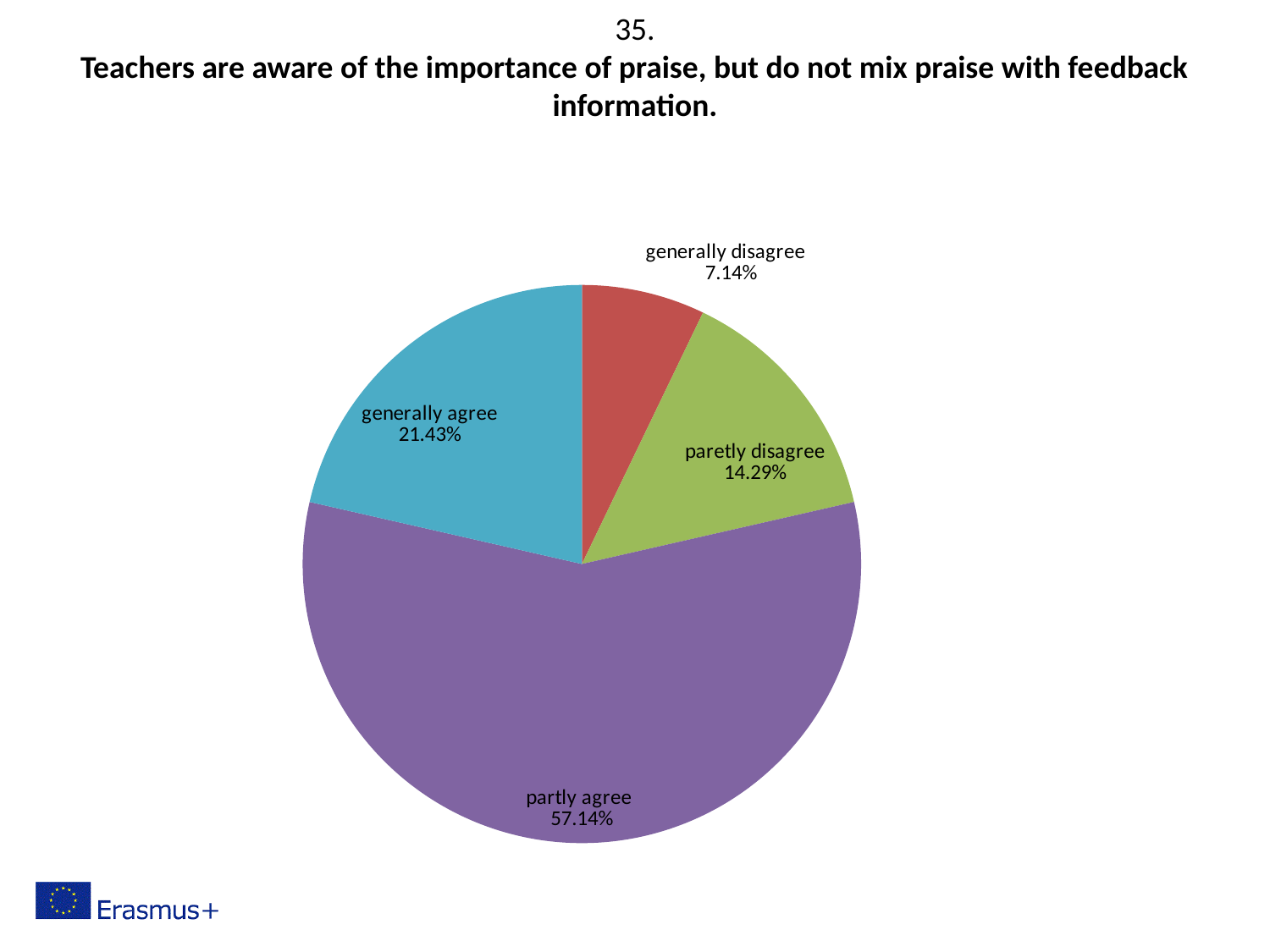
What share of the pie is labelled "generally agree"? 21.43% What is the difference in percentage points between the "partly agree" and "generally agree" shares? 35.71 Which is larger, the share for "generally agree" or the share for "paretly disagree"? generally agree What share of the pie is labelled "paretly disagree"? 14.29% What share of the pie is labelled "partly agree"? 57.14% What colour is the "partly agree" slice? purple Which category has the smallest slice of the pie? generally disagree What kind of chart is shown on the slide? pie chart What share of the pie is labelled "generally disagree"? 7.14% What is the difference in percentage points between the "paretly disagree" and "generally disagree" shares? 7.15 How many slices does the pie chart have? 4 Which category has the largest slice of the pie? partly agree